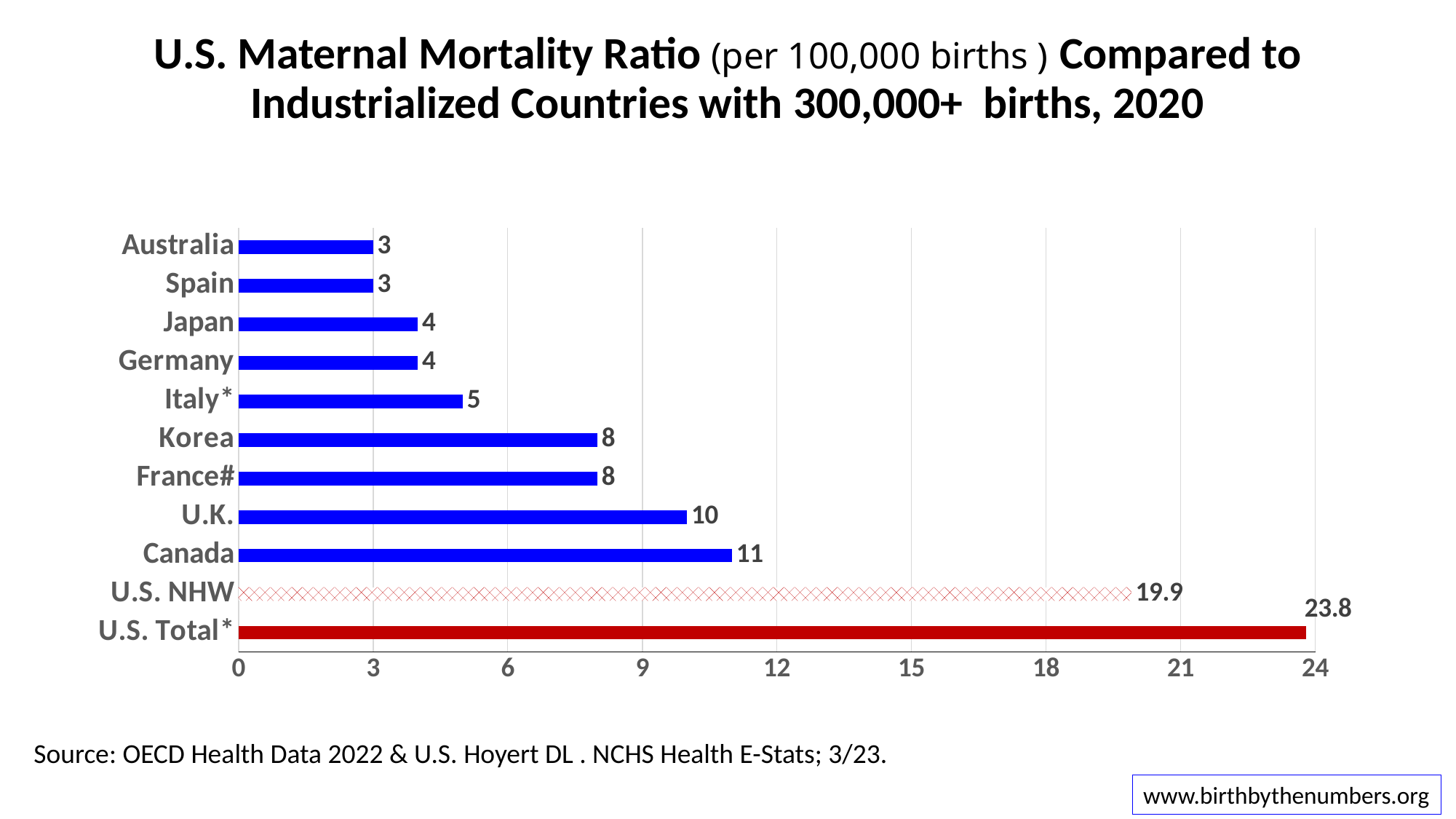
How many categories are shown on the chart? 11 Which category has the highest value on the chart? U.S. Total* Which has a larger value, the U.K. or Korea? U.K. What is the difference between the U.S. Total* value and the Canada value? 12.8 What is the value shown for U.S. NHW? 19.9 What kind of chart is shown on the slide? Bar chart What colour is the U.S. Total* bar? Red Is the value for U.S. NHW greater or less than 18? greater What is the maternal mortality ratio shown for Canada? 11 What is the difference between the U.S. Total* value and the U.S. NHW value? 3.9 What is the value shown for U.S. Total*? 23.8 What is the value shown for Italy*? 5